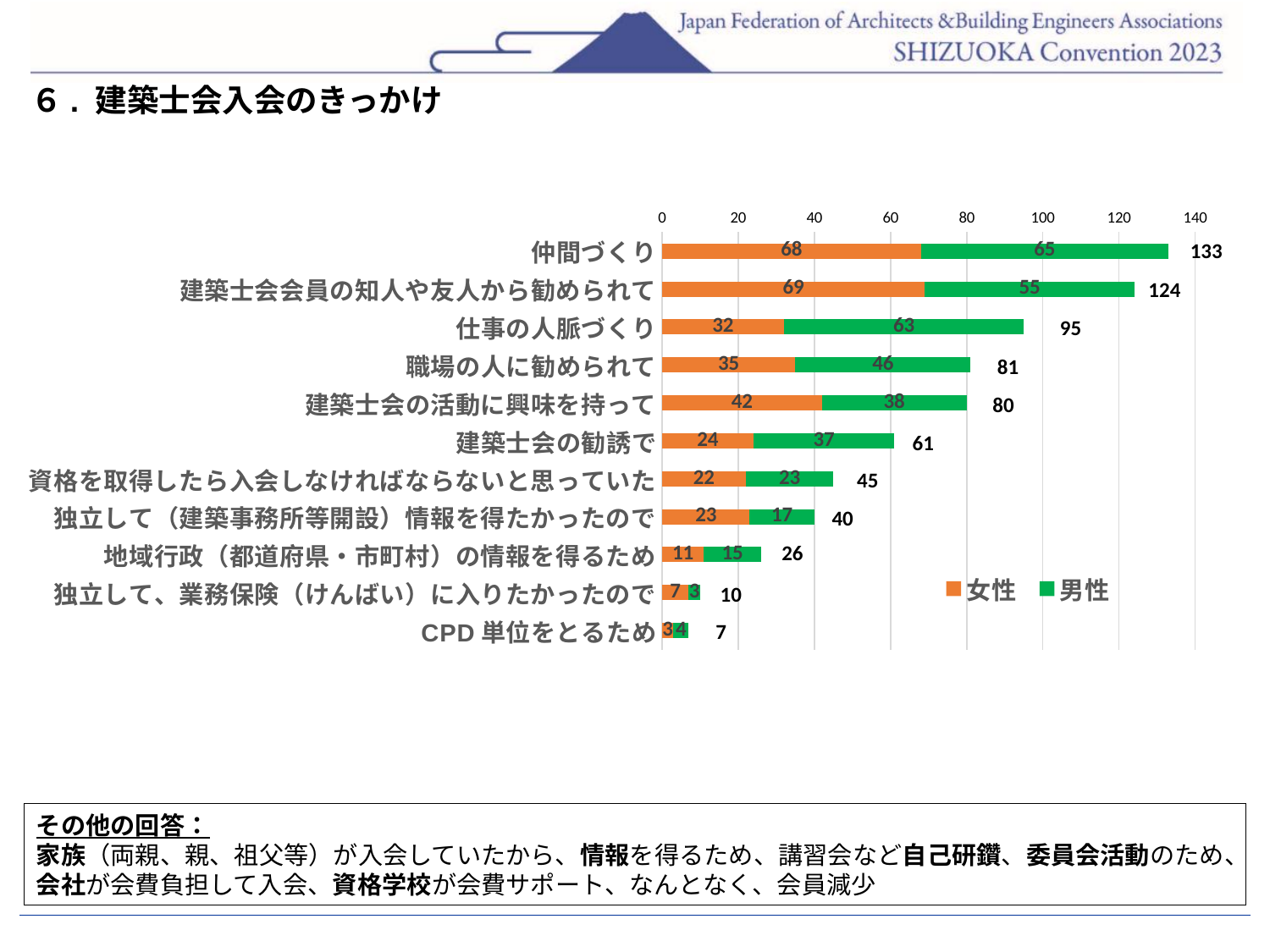
Which is larger for 職場の人に勧められて, the 女性 value or the 男性 value? 男性 What is the difference between the 女性 and 男性 values for 建築士会会員の知人や友人から勧められて? 14 What is the 女性 value for 仲間づくり? 68 How many categories are shown in the chart? 11 Which colour represents 女性 in the chart? orange What is the 男性 value for 仕事の人脈づくり? 63 How many series does the legend list? 2 What kind of chart is shown on the slide? stacked bar chart Which category has the lowest total? CPD 単位をとるため Is the total for 仕事の人脈づくり greater or less than 100? less Which category has the highest total? 仲間づくり What is the total for 建築士会の勧誘で? 61